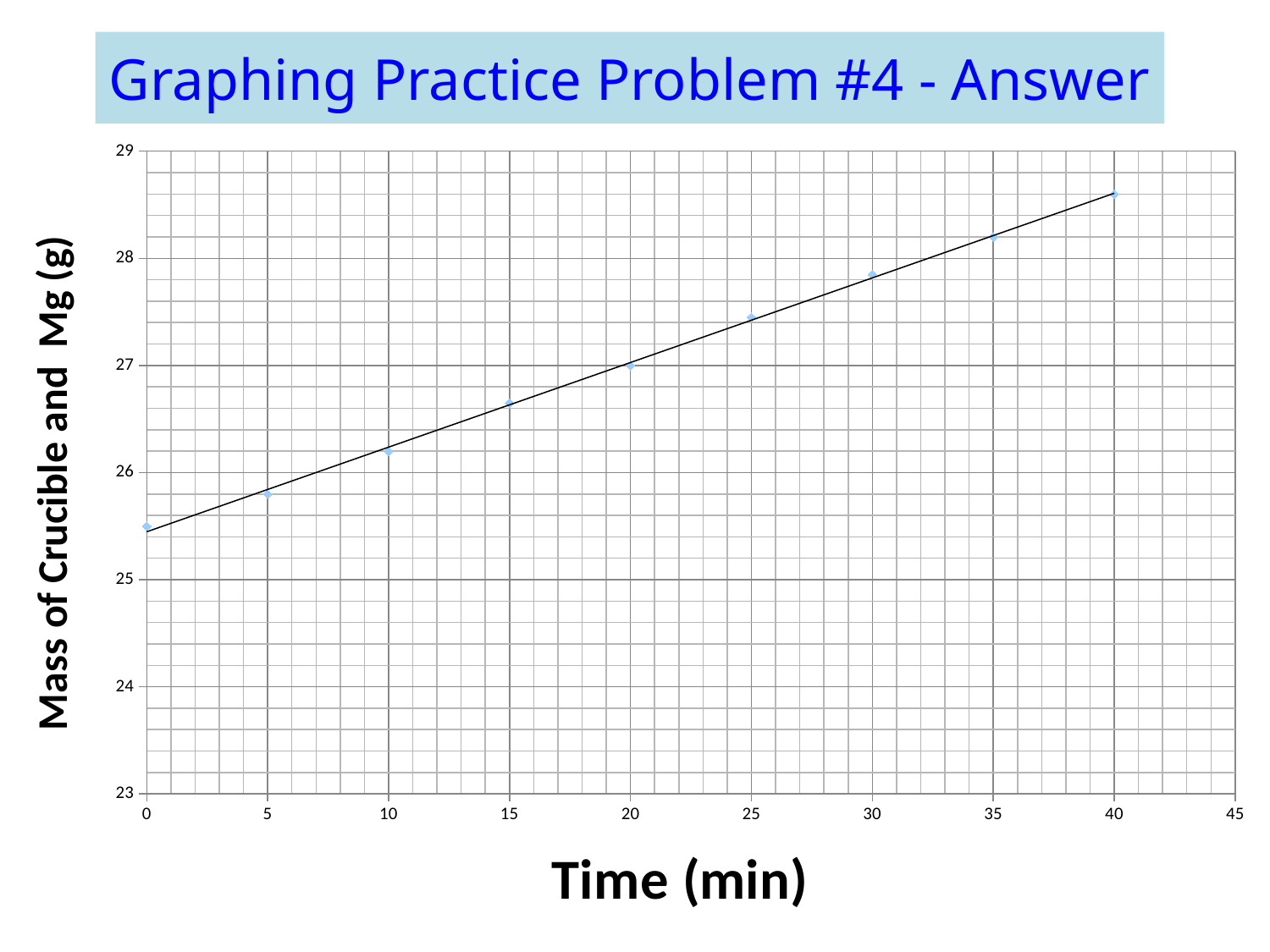
Do the mass values rise or fall as time increases along the x axis? Rise Is the mass at 40 min greater or less than 28 g? greater What is the label of the x axis? Time (min) How many data points are plotted on the chart? 9 Which has the larger mass: the point at 10 min or the point at 30 min? 30 min At which time (min) is the mass of crucible and Mg highest? 40 Is the mass at 15 min greater or less than 27 g? less At which time (min) is the mass of crucible and Mg lowest? 0 Is the mass at 25 min greater or less than 27 g? greater What kind of chart is shown on the slide? Scatter plot with a trend line What is the label of the y axis? Mass of Crucible and Mg (g)